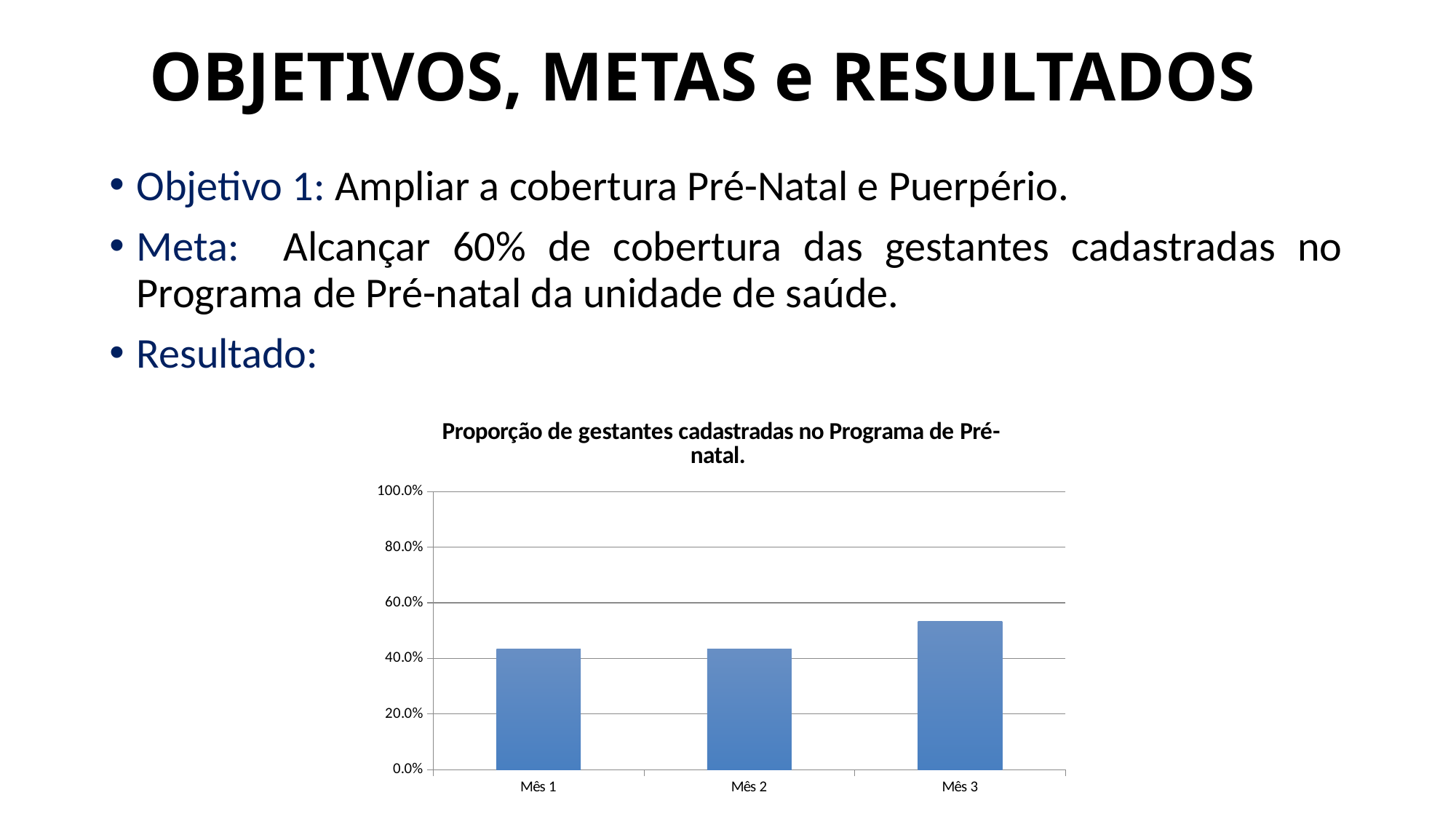
Which category has the highest value in the chart? Mês 3 Is the value for Mês 1 greater or less than 40.0%? greater What is the title of the chart? Proporção de gestantes cadastradas no Programa de Pré-natal. Does the value rise or fall from Mês 2 to Mês 3? rise How many categories are plotted on the x axis of the chart? 3 Is the value for Mês 3 greater or less than 60.0%? less What kind of chart is shown on the slide? bar chart Is the value for Mês 3 greater or less than 40.0%? greater Which is larger, the value for Mês 1 or the value for Mês 3? Mês 3 What is the highest value shown on the chart's vertical axis? 100.0%